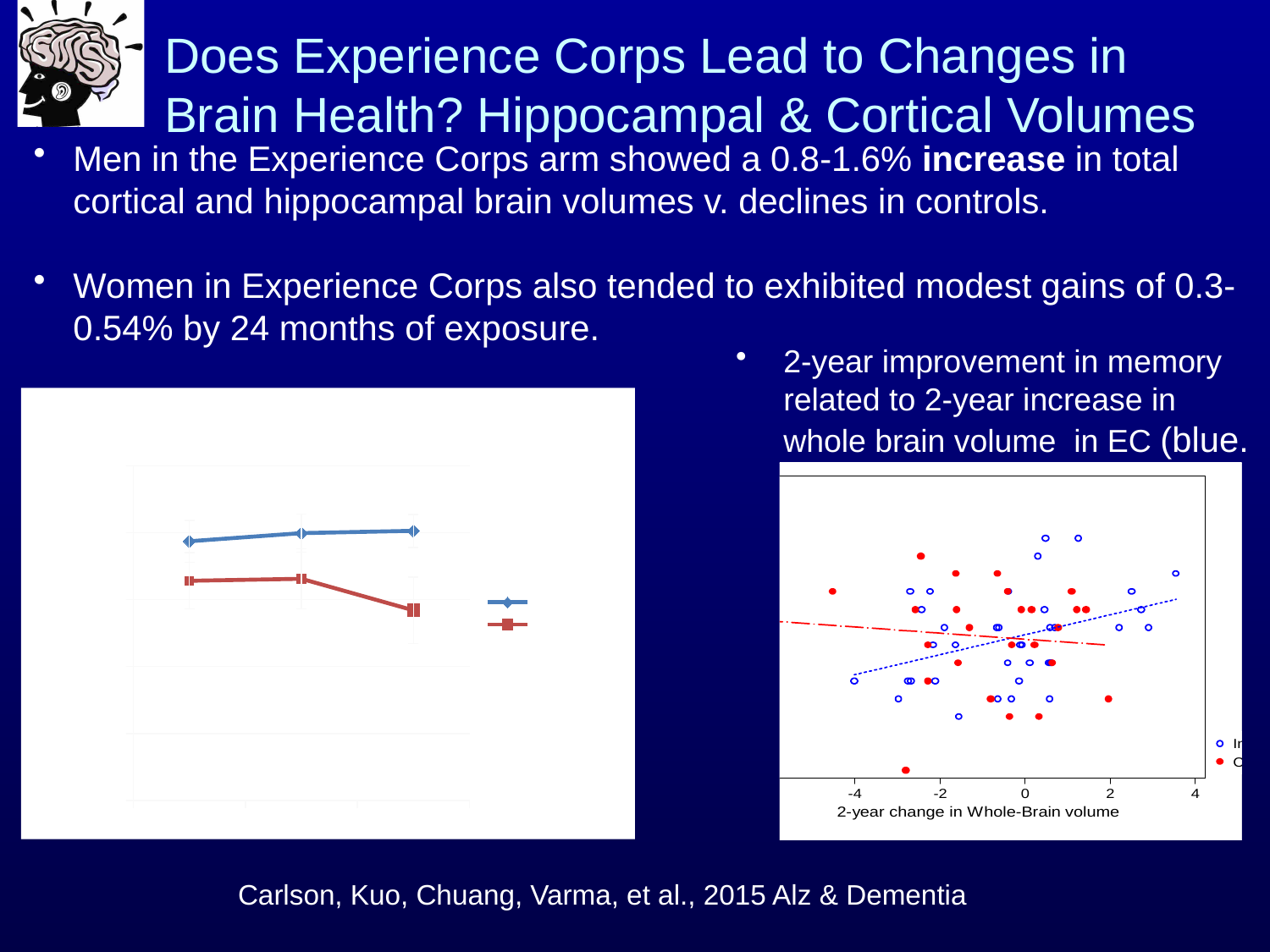
In the right chart, how many groups of points are distinguished by colour? 2 In the left chart, which line is plotted higher, the blue line or the red line? the blue line What kind of chart is the chart on the right side of the slide? scatter plot In the right chart, does the blue dotted fitted line rise or fall from left to right? rise What kind of chart is the chart on the left side of the slide? line chart In the left chart, how many data points does the blue line have? 3 In the right chart, what is the label of the x axis? 2-year change in Whole-Brain volume In the left chart, how many series are plotted? 2 In the right chart, does the red dash-dot fitted line rise or fall from left to right? fall In the right chart, what is the lowest tick value shown on the x axis? -4 In the left chart, does the blue line rise or fall from left to right? rise